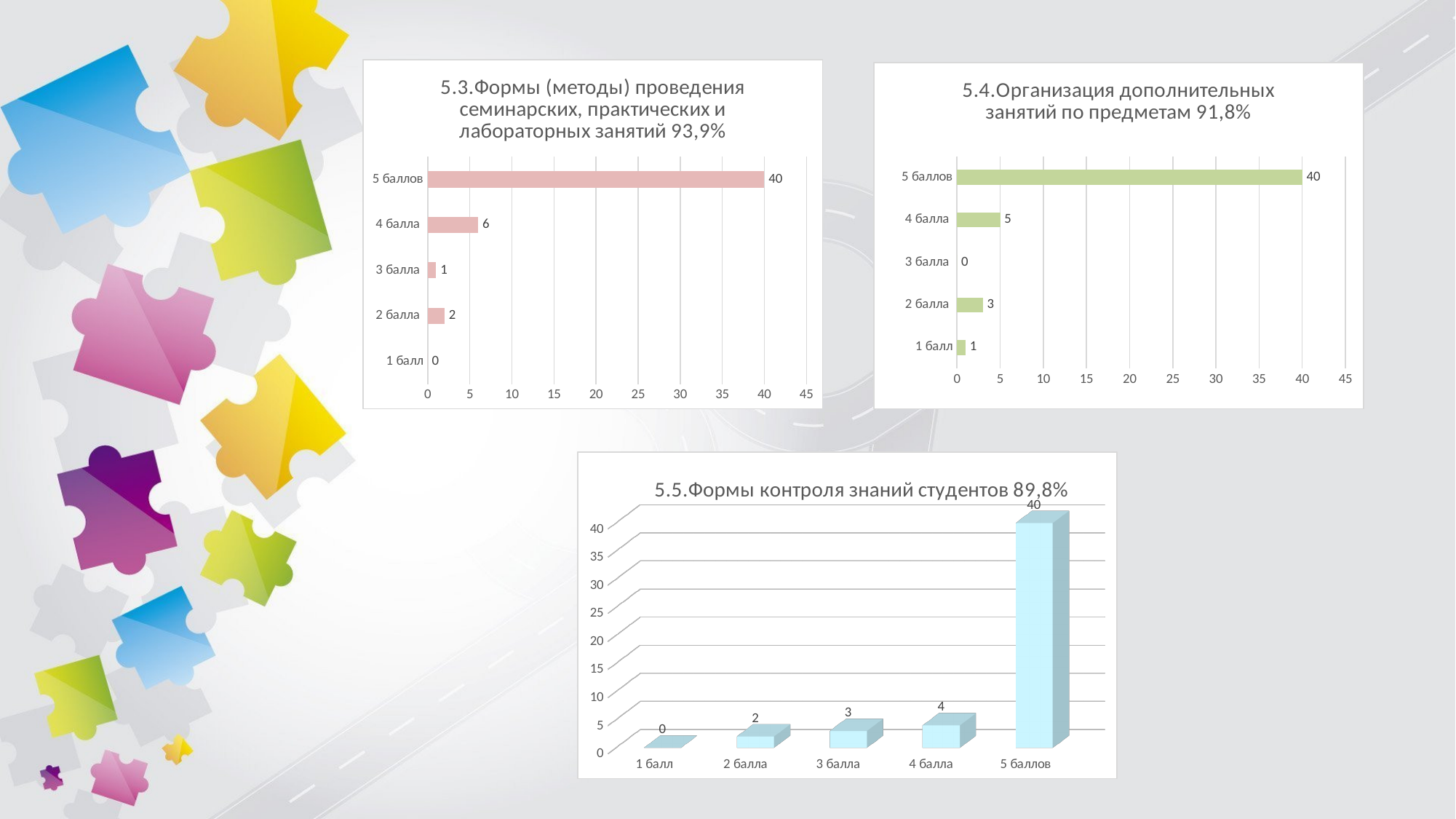
In the chart titled "5.3.Формы (методы) проведения семинарских, практических и лабораторных занятий 93,9%", what is the difference between the values for "5 баллов" and "4 балла"? 34 In the chart titled "5.4.Организация дополнительных занятий по предметам 91,8%", what is the value for "2 балла"? 3 In the chart titled "5.4.Организация дополнительных занятий по предметам 91,8%", what type of chart is used? Bar chart In the chart titled "5.5.Формы контроля знаний студентов 89,8%", what is the value for "3 балла"? 3 In the chart titled "5.3.Формы (методы) проведения семинарских, практических и лабораторных занятий 93,9%", which category has the highest value? 5 баллов In the chart titled "5.5.Формы контроля знаний студентов 89,8%", do the values rise or fall from "1 балл" to "5 баллов"? Rise In the chart titled "5.5.Формы контроля знаний студентов 89,8%", what is the difference between the values for "5 баллов" and "4 балла"? 36 In the chart titled "5.3.Формы (методы) проведения семинарских, практических и лабораторных занятий 93,9%", how many categories are shown? 5 In the chart titled "5.4.Организация дополнительных занятий по предметам 91,8%", which category has the lowest value? 3 балла In the chart titled "5.3.Формы (методы) проведения семинарских, практических и лабораторных занятий 93,9%", what is the value for "4 балла"? 6 How many charts are shown on the slide? 3 In the chart titled "5.4.Организация дополнительных занятий по предметам 91,8%", which is larger, the value for "4 балла" or the value for "2 балла"? 4 балла